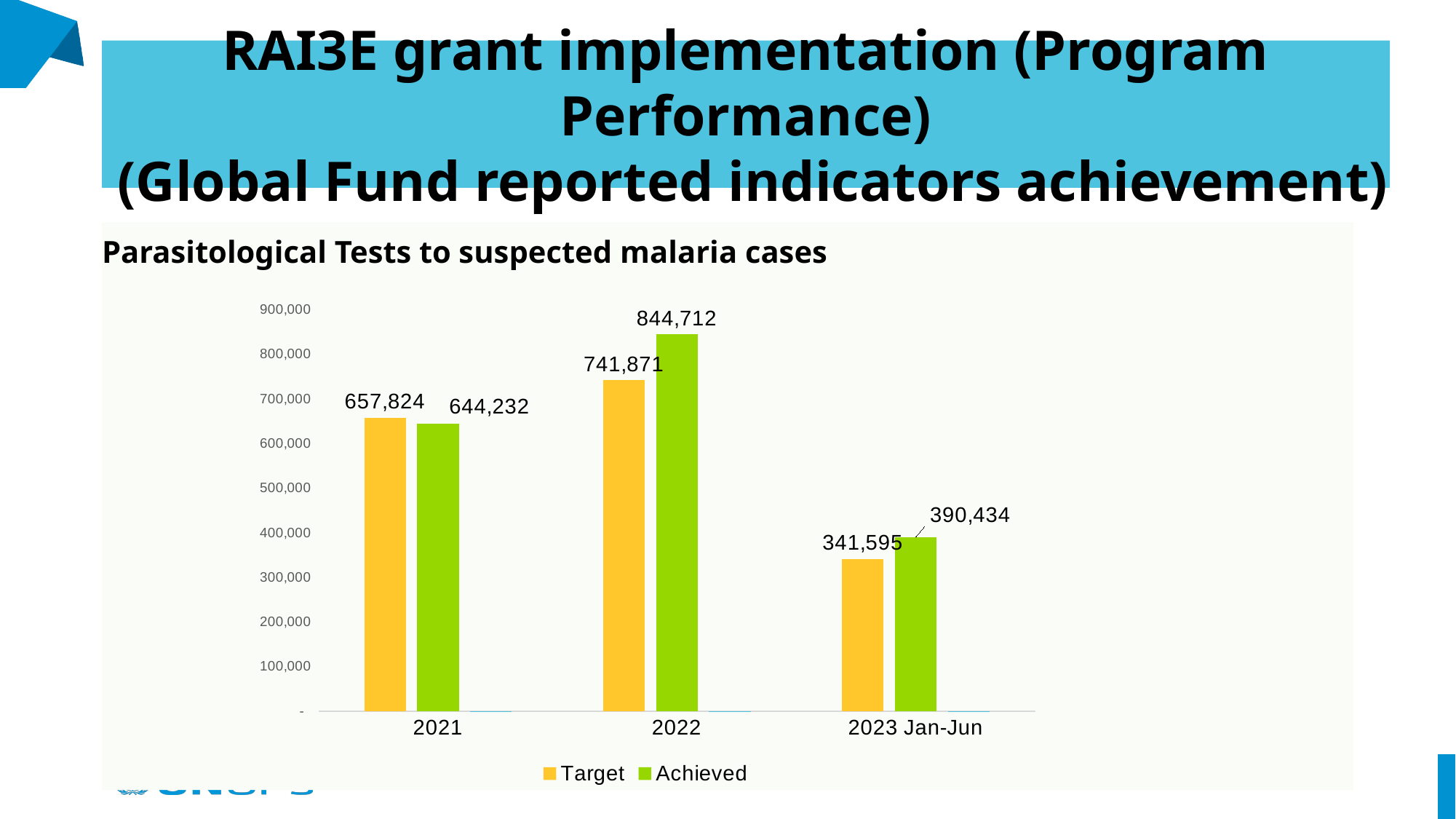
What is the Achieved value for 2023 Jan-Jun? 390,434 Which year has the highest Achieved value? 2022 What is the Achieved value for 2021? 644,232 What is the Target value for 2022? 741,871 Is the Target value for 2023 Jan-Jun greater or less than 400,000? less What type of chart is shown on the slide? bar chart What is the difference between the Achieved and Target values for 2022? 102,841 How many categories are shown on the x axis? 3 What is the difference between the Target and Achieved values for 2021? 13,592 How many series does the legend list? 2 In 2021, which is larger, the Target or the Achieved value? Target Which category has the lowest Target value? 2023 Jan-Jun